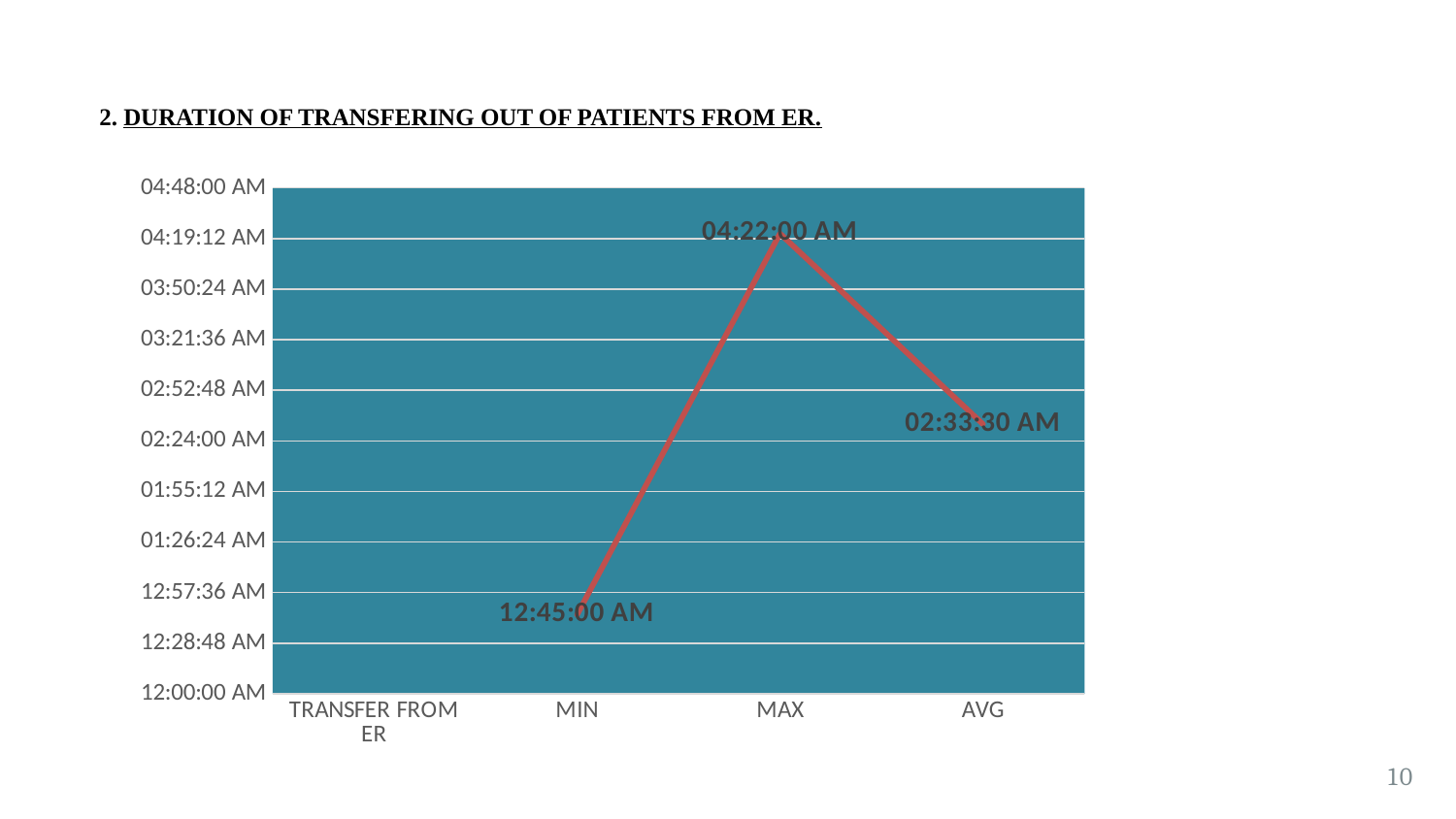
What is the value plotted for MAX? 04:22:00 AM Does the line rise or fall from MIN to MAX? Rise What is the title of the chart on the slide? 2. DURATION OF TRANSFERING OUT OF PATIENTS FROM ER. What is the value plotted for AVG? 02:33:30 AM Which category has the highest plotted value? MAX Is the value for AVG greater or less than 02:24:00 AM? greater Which is larger, the value for AVG or the value for MIN? AVG How many categories are shown on the x axis? 4 Which category has the lowest plotted value? MIN Is the value for MAX greater or less than 03:50:24 AM? greater What kind of chart is shown on the slide? Line chart What is the value plotted for MIN? 12:45:00 AM